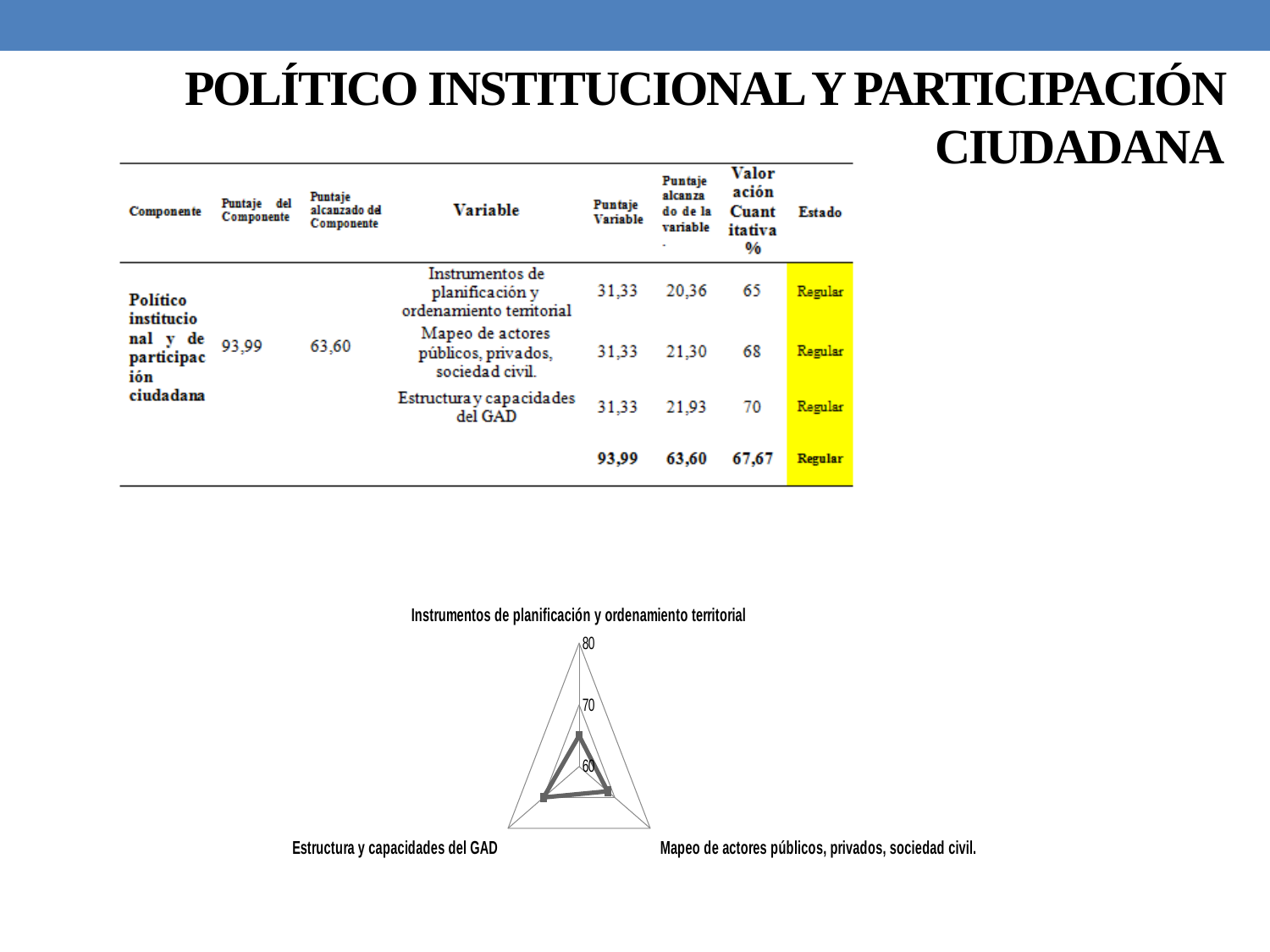
Which category label appears at the top of the radar chart? Instrumentos de planificación y ordenamiento territorial In the radar chart, which category has the lowest value? Instrumentos de planificación y ordenamiento territorial How many categories (axes) does the radar chart have? 3 What kind of chart is shown at the bottom of the slide? Radar chart In the radar chart, is the value for Estructura y capacidades del GAD greater or less than 60? greater In the radar chart, is the value for Instrumentos de planificación y ordenamiento territorial greater or less than 60? greater In the radar chart, which is larger: the value for Instrumentos de planificación y ordenamiento territorial or the value for Estructura y capacidades del GAD? Estructura y capacidades del GAD What is the highest tick value shown on the radar chart's axis? 80 In the radar chart, is the value for Instrumentos de planificación y ordenamiento territorial greater or less than 70? less